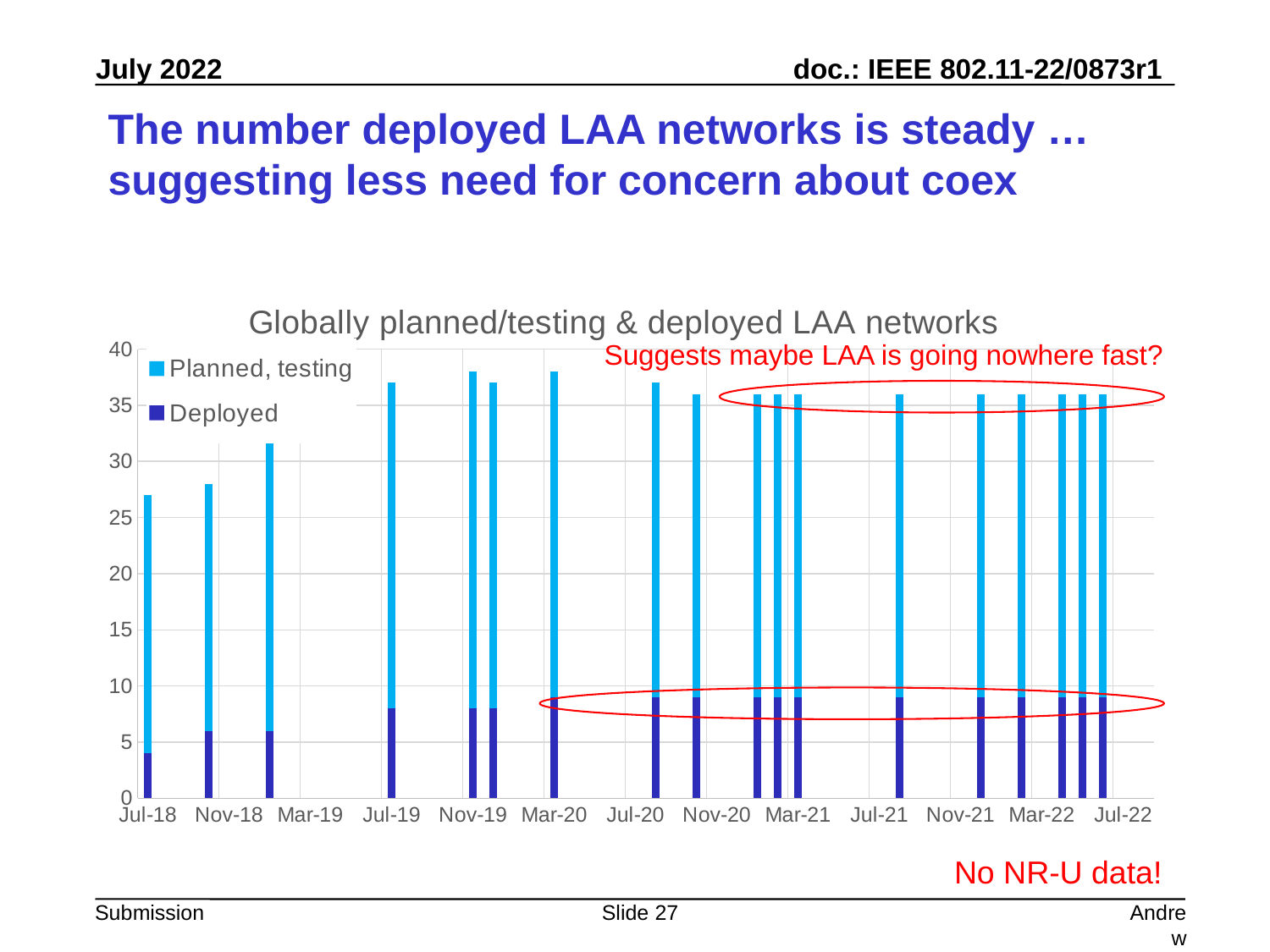
Which series is shown in dark blue in the chart? Deployed Is the total height of the bar at Jul-19 greater or less than 35? greater Is the total height of the bar at Jul-18 greater or less than 30? less Which bar has the larger total height, Jul-18 or Jul-19? Jul-19 Which bar has the lowest total height in the chart? Jul-18 What kind of chart is shown on the slide? Stacked bar chart Does the Deployed series rise or fall from Jul-18 to Jul-19? rise How many series does the chart legend list? 2 Is the Deployed value for the bar at Jul-19 greater or less than 5? greater What is the title of the chart? Globally planned/testing & deployed LAA networks